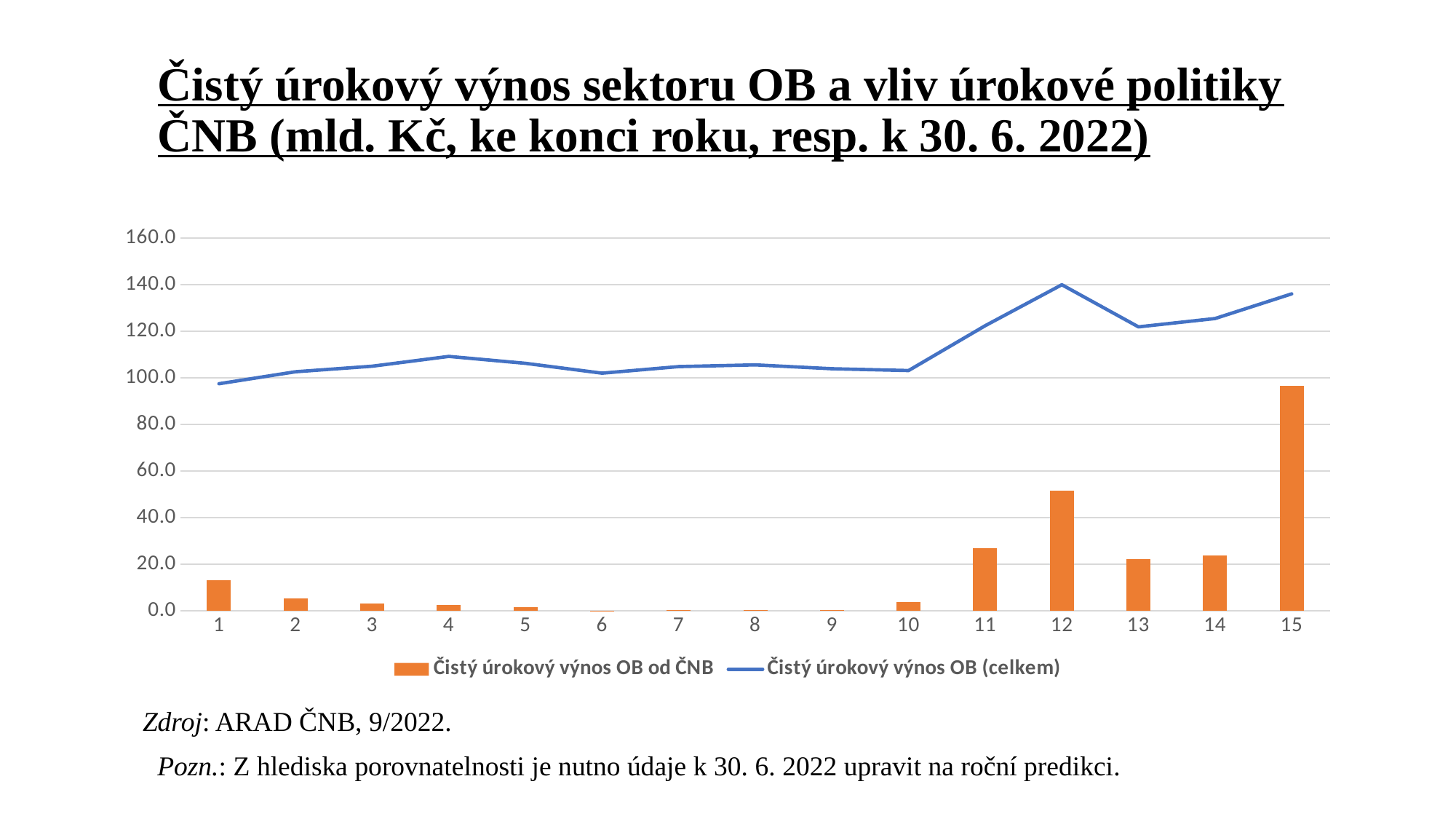
What kind of chart is shown? Combined bar and line chart Which category has the highest value for the bar series 'Čistý úrokový výnos OB od ČNB'? 15 Does the line 'Čistý úrokový výnos OB (celkem)' rise or fall from category 10 to category 12? rise Is the bar value for category 12 greater or less than 40? greater Which has the larger bar value, category 12 or category 11? 12 How many series does the legend list? 2 Is the bar value for category 11 greater or less than 20? greater Which has the larger bar value, category 1 or category 13? 13 Is the line value 'Čistý úrokový výnos OB (celkem)' for category 12 greater or less than 120? greater How many categories are shown on the x axis? 15